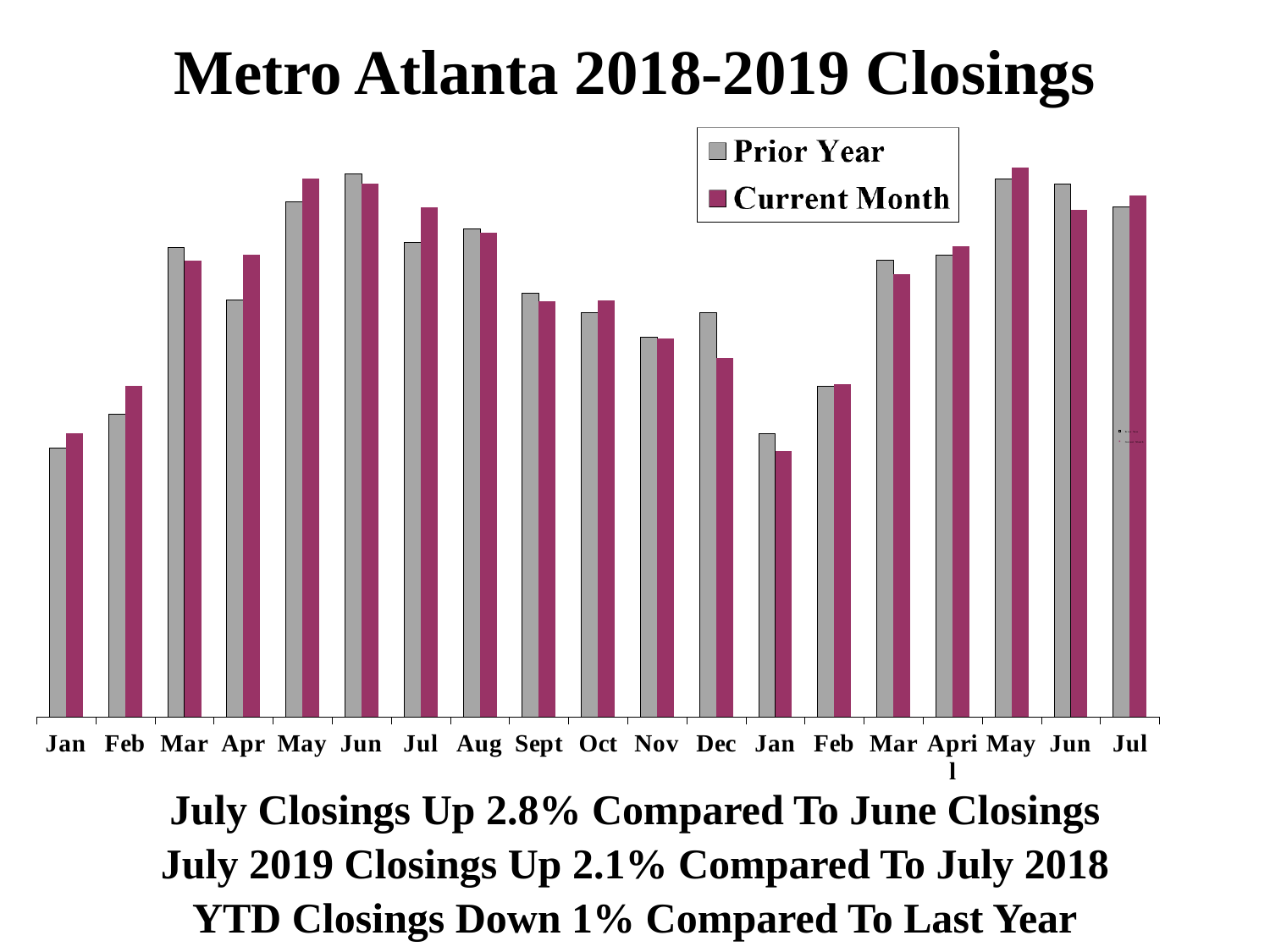
Which series is drawn in gray bars? Prior Year For Dec, which is larger: the Prior Year bar or the Current Month bar? Prior Year Do the Current Month bars rise or fall from the first Jun through Dec? Fall In which month category is the Current Month bar the tallest? May (2019, the second May) How many series does the legend list? 2 What kind of chart is shown on the slide? Bar chart Do the Current Month bars rise or fall from the second Jan through the second May? Rise For the second Jun (2019), which is larger: the Prior Year bar or the Current Month bar? Prior Year For the first Apr, which is larger: the Prior Year bar or the Current Month bar? Current Month What is the title of the chart? Metro Atlanta 2018-2019 Closings How many month categories are shown along the x axis? 19 In which month category is the Current Month bar the shortest? Jan (2019, the second Jan)